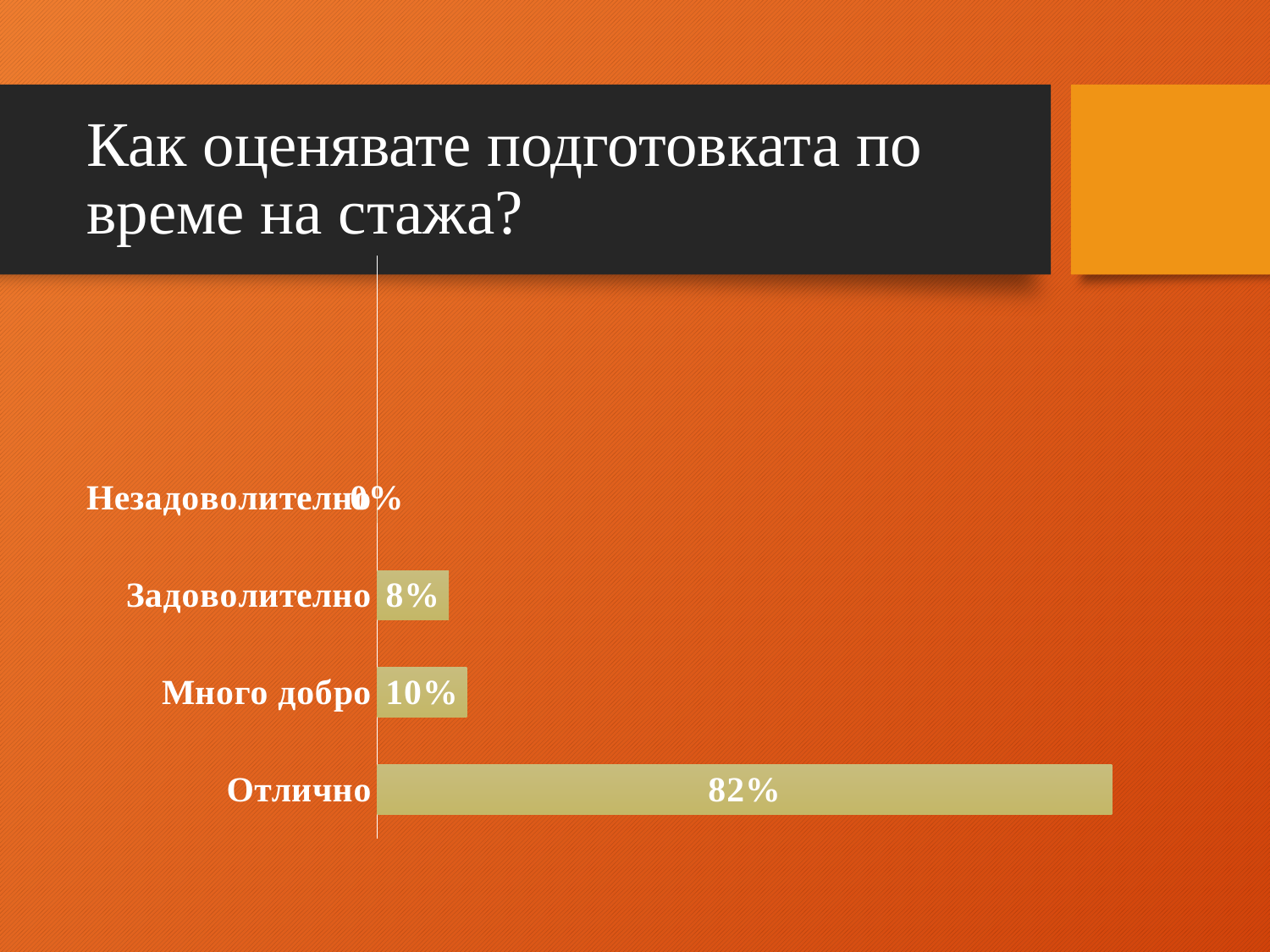
What kind of chart is shown on the slide? Bar chart Which category has the highest value? Отлично What value is shown for Много добро? 10% Which is larger, the value for Много добро or the value for Задоволително? Много добро What is the difference between the values for Отлично and Много добро? 72% What value is shown for Отлично? 82% How many categories are shown in the chart? 4 What value is shown for Незадоволително? 0% Which category has the lowest value? Незадоволително What value is shown for Задоволително? 8% What is the title of the slide containing the chart? Как оценявате подготовката по време на стажа? What is the difference between the values for Много добро and Задоволително? 2%